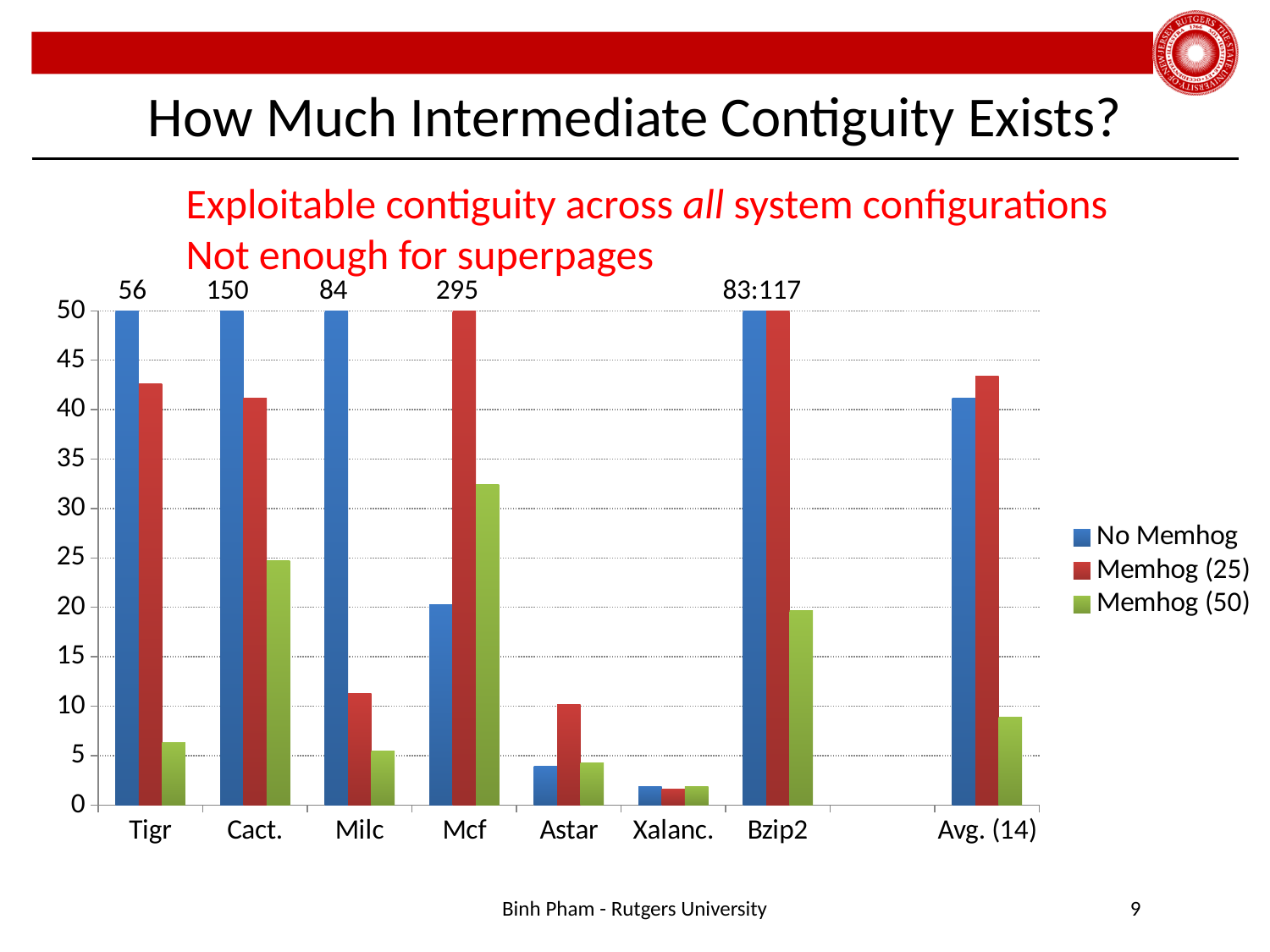
Which category has the lowest values across all three series? Xalanc. For Tigr, which is larger: Memhog (25) or Memhog (50)? Memhog (25) Is the Memhog (25) value for Avg. (14) greater or less than 40? greater What is the No Memhog value for Tigr, as printed above the chart? 56 Is the Memhog (50) value for Mcf greater or less than 30? greater How many categories are shown on the x axis? 8 What kind of chart is shown on the slide? bar chart What label is printed above the Bzip2 bars? 83:117 What is the difference between the printed No Memhog values for Cact. and Tigr? 94 What is the No Memhog value for Cact., as printed above the chart? 150 How many series does the legend list? 3 What is the Memhog (25) value for Mcf, as printed above the chart? 295